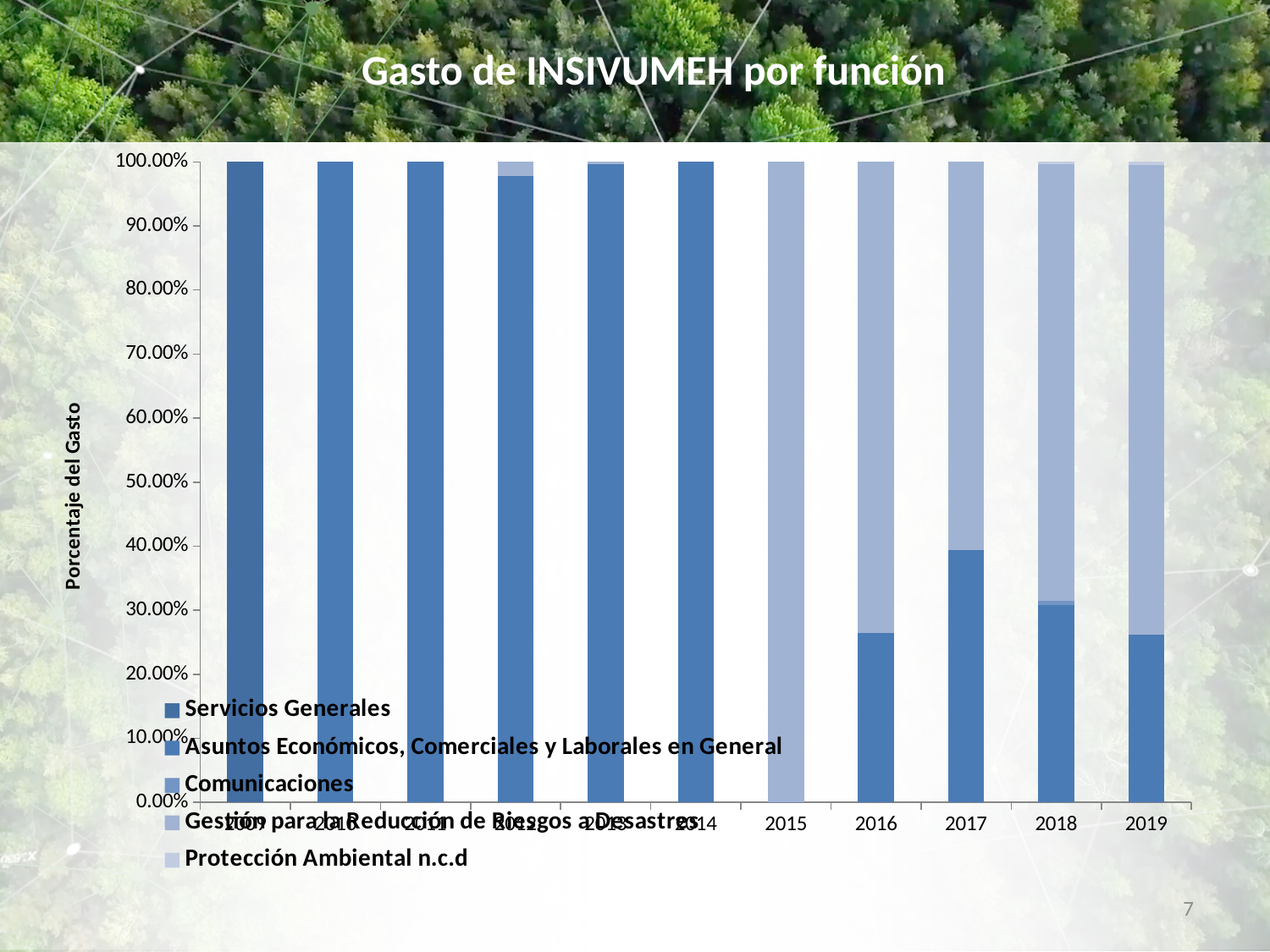
What kind of chart is shown on the slide? Stacked bar chart What is the label of the vertical axis? Porcentaje del Gasto What is the title of the chart? Gasto de INSIVUMEH por función How many years are shown along the x axis? 11 How many series does the legend list? 5 What is the total of the stacked bar for 2009? 100.00%